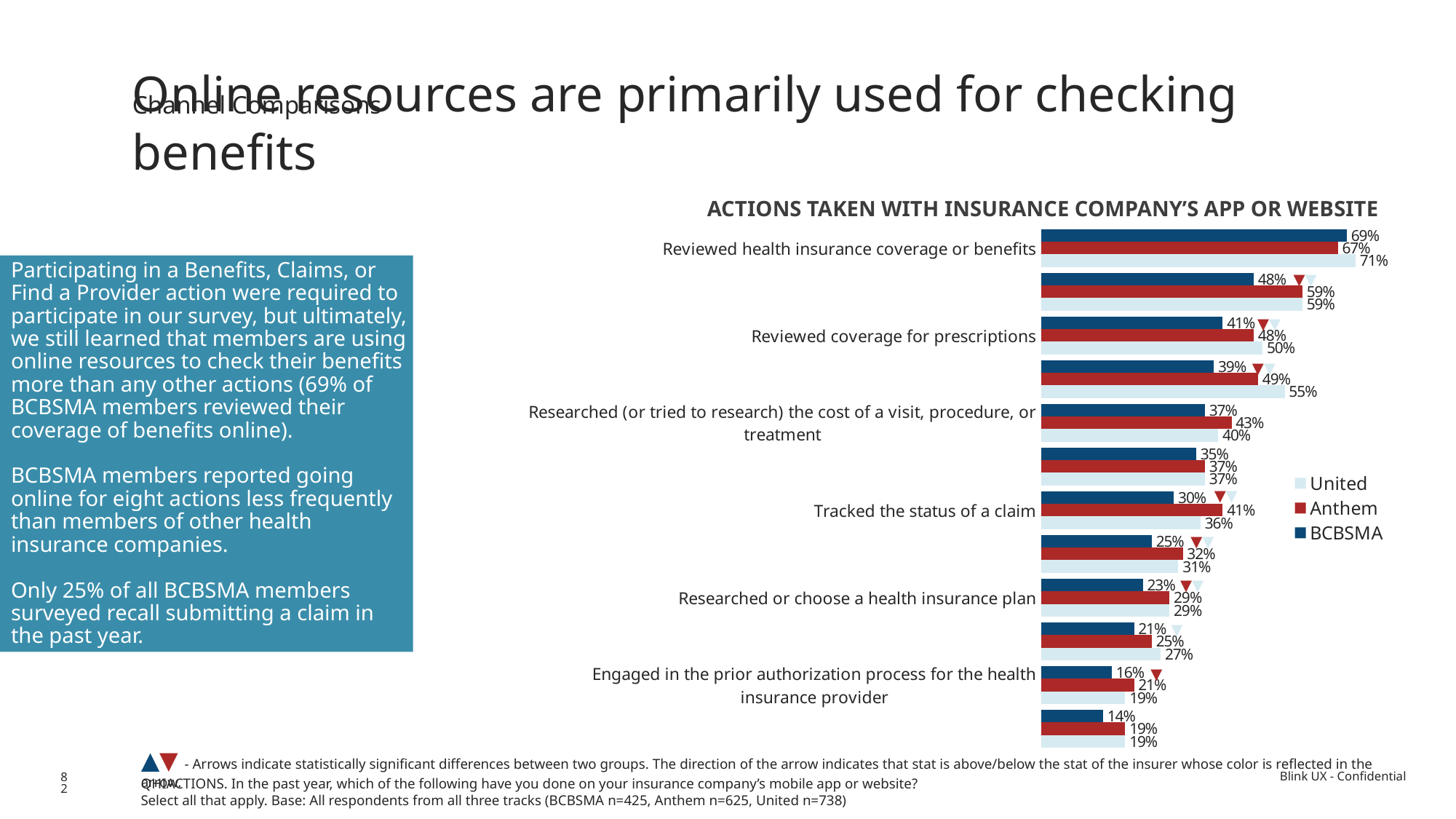
What type of chart is shown on the slide? Bar chart What is the United value for 'Reviewed health insurance coverage or benefits'? 71% Which series has the lowest value for 'Researched or choose a health insurance plan'? BCBSMA What is the difference between the United and BCBSMA values for 'Reviewed coverage for prescriptions'? 9% What is the Anthem value for 'Reviewed coverage for prescriptions'? 48% For 'Researched (or tried to research) the cost of a visit, procedure, or treatment', which is larger: the Anthem value or the United value? Anthem How many series does the legend list? 3 What is the difference between the Anthem and BCBSMA values for 'Tracked the status of a claim'? 11% What is the BCBSMA value for 'Tracked the status of a claim'? 30% What is the United value for 'Engaged in the prior authorization process for the health insurance provider'? 19% What is the BCBSMA value for 'Reviewed health insurance coverage or benefits'? 69% Which series has the highest value for 'Reviewed health insurance coverage or benefits'? United